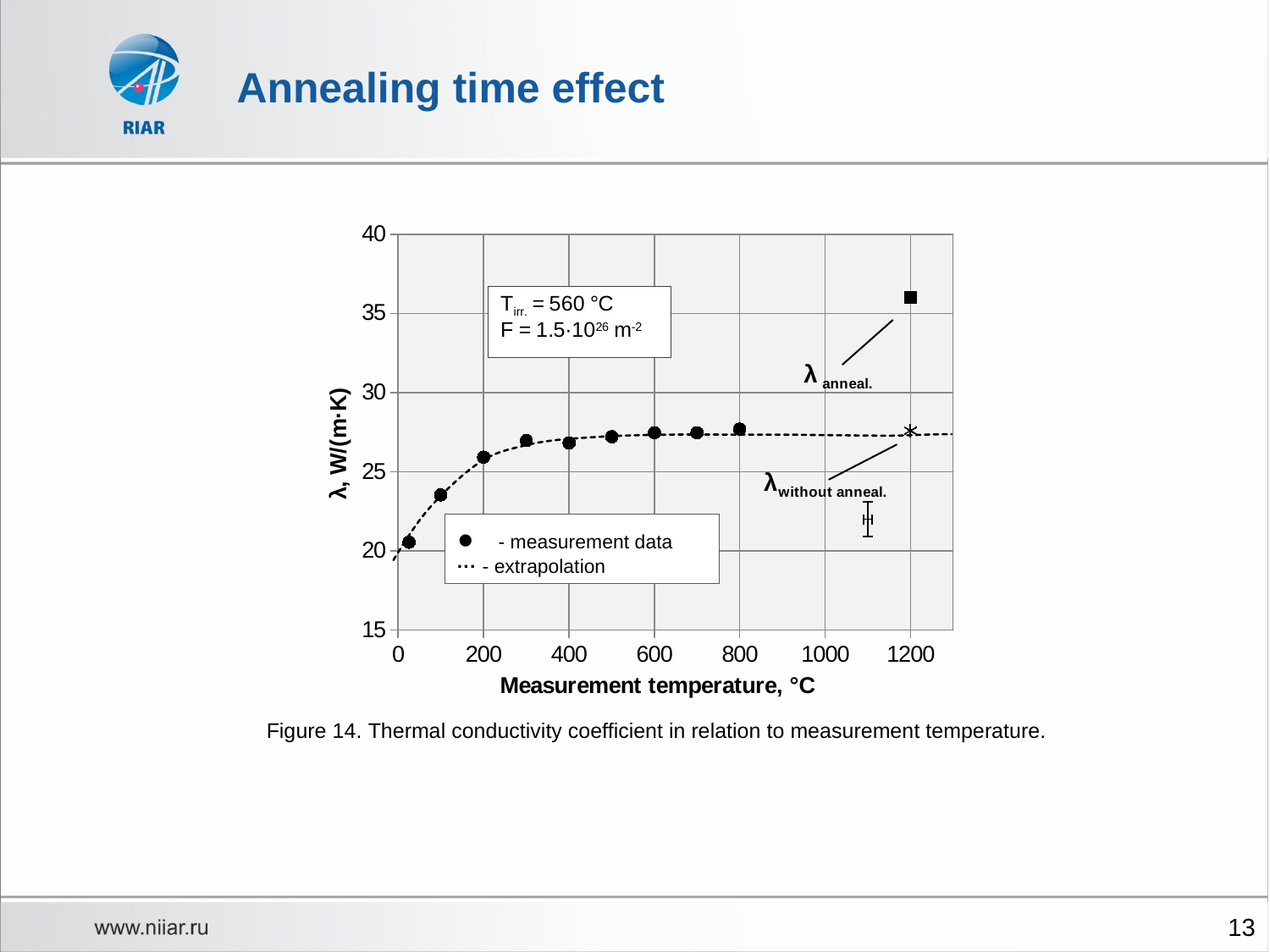
Is the λ anneal. value at 1200 °C greater or less than 35? greater Is the measurement data value at 100 °C greater or less than 25? less Is the λ without anneal. value at 1200 °C greater or less than 30? less Do the measurement data values rise or fall as measurement temperature increases from 0 to 800 °C? Rise What kind of chart is shown on the slide? Scatter plot with a dashed extrapolation line At 1200 °C, which is larger: λ anneal. or λ without anneal.? λ anneal. What is the title of the y axis? λ, W/(m·K) How many entries does the legend list? 2 Which plotted point has the highest thermal conductivity value? λ anneal. at 1200 °C How many black circle measurement data points are plotted? 9 What is the title of the x axis? Measurement temperature, °C